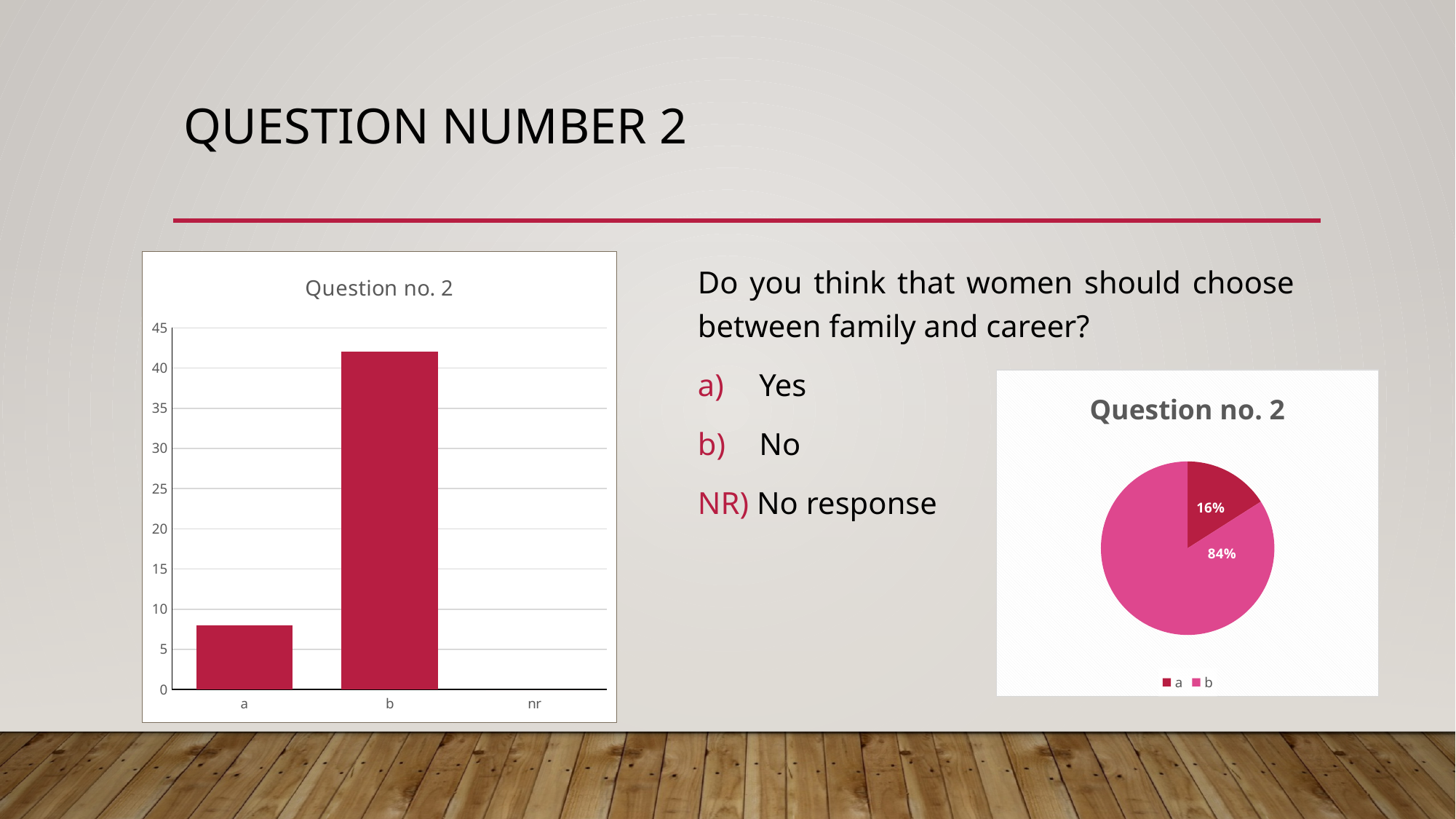
In the pie chart on the right, what is the difference between the share of b and the share of a? 68% In the bar chart on the left, which category has the lowest value? nr In the pie chart on the right, what share does slice a have? 16% In the bar chart on the left, which is larger, the value for a or the value for b? b In the pie chart on the right, what share does slice b have? 84% In the bar chart on the left, which category has the highest bar? b In the bar chart on the left, how many categories are shown on the x axis? 3 What kind of chart is the chart on the left of the slide? bar chart In the bar chart on the left, is the value for a greater or less than 10? less What kind of chart is the chart on the right of the slide? pie chart In the pie chart on the right, how many entries does the legend list? 2 In the bar chart on the left, is the value for b greater or less than 40? greater